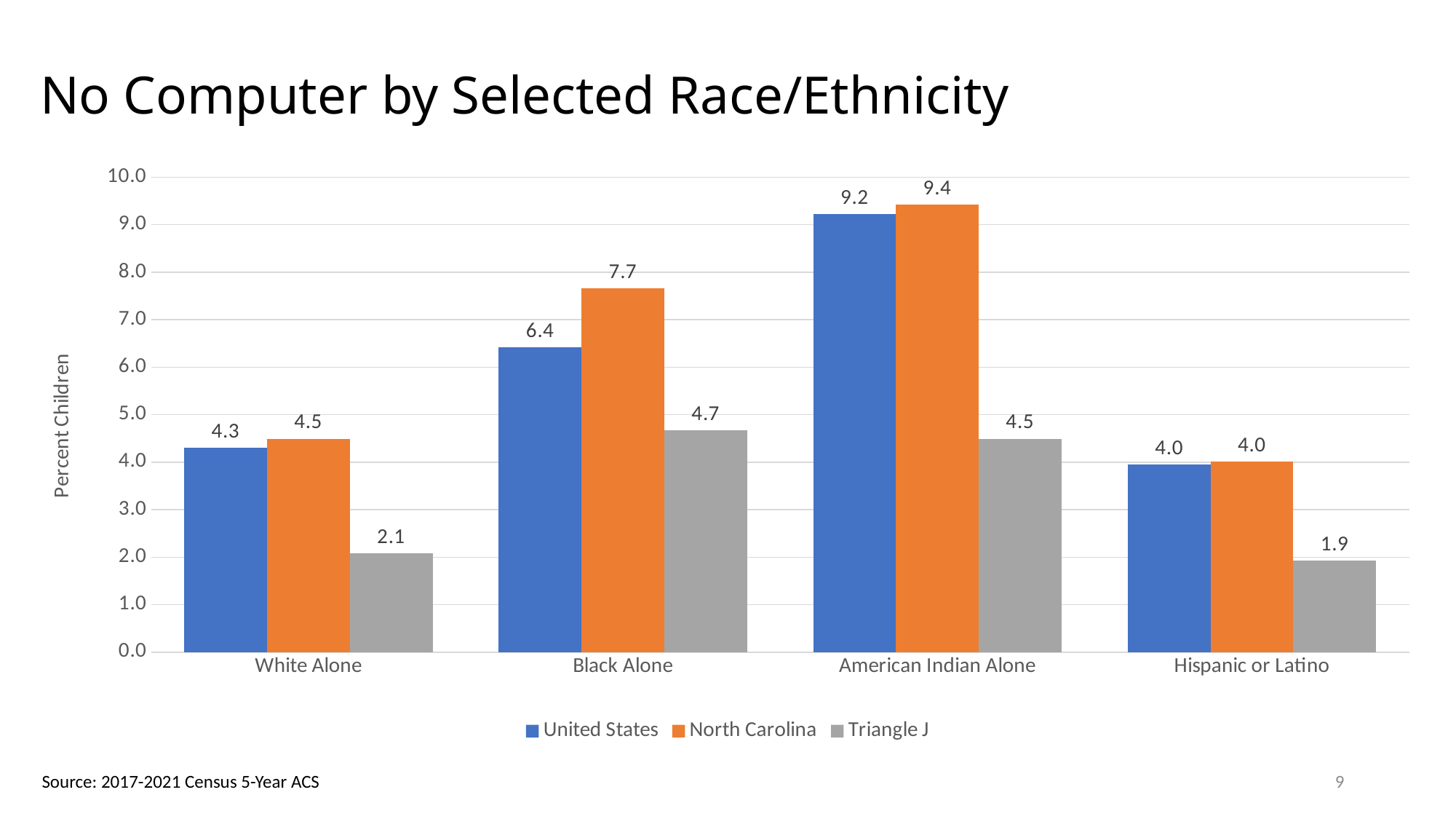
Which category has the highest value for Triangle J? Black Alone How many series does the legend list? 3 Which category has the lowest value for North Carolina? Hispanic or Latino Is the value for North Carolina in the American Indian Alone category greater or less than 8.0? greater What kind of chart is shown on the slide? bar chart What is the value for North Carolina in the Black Alone category? 7.7 What is the value for United States in the American Indian Alone category? 9.2 Which is larger for American Indian Alone: the United States value or the Triangle J value? United States What is the label on the vertical axis? Percent Children How many race/ethnicity categories are shown on the x axis? 4 What is the difference between the North Carolina and United States values for Black Alone? 1.3 What is the value for Triangle J in the White Alone category? 2.1